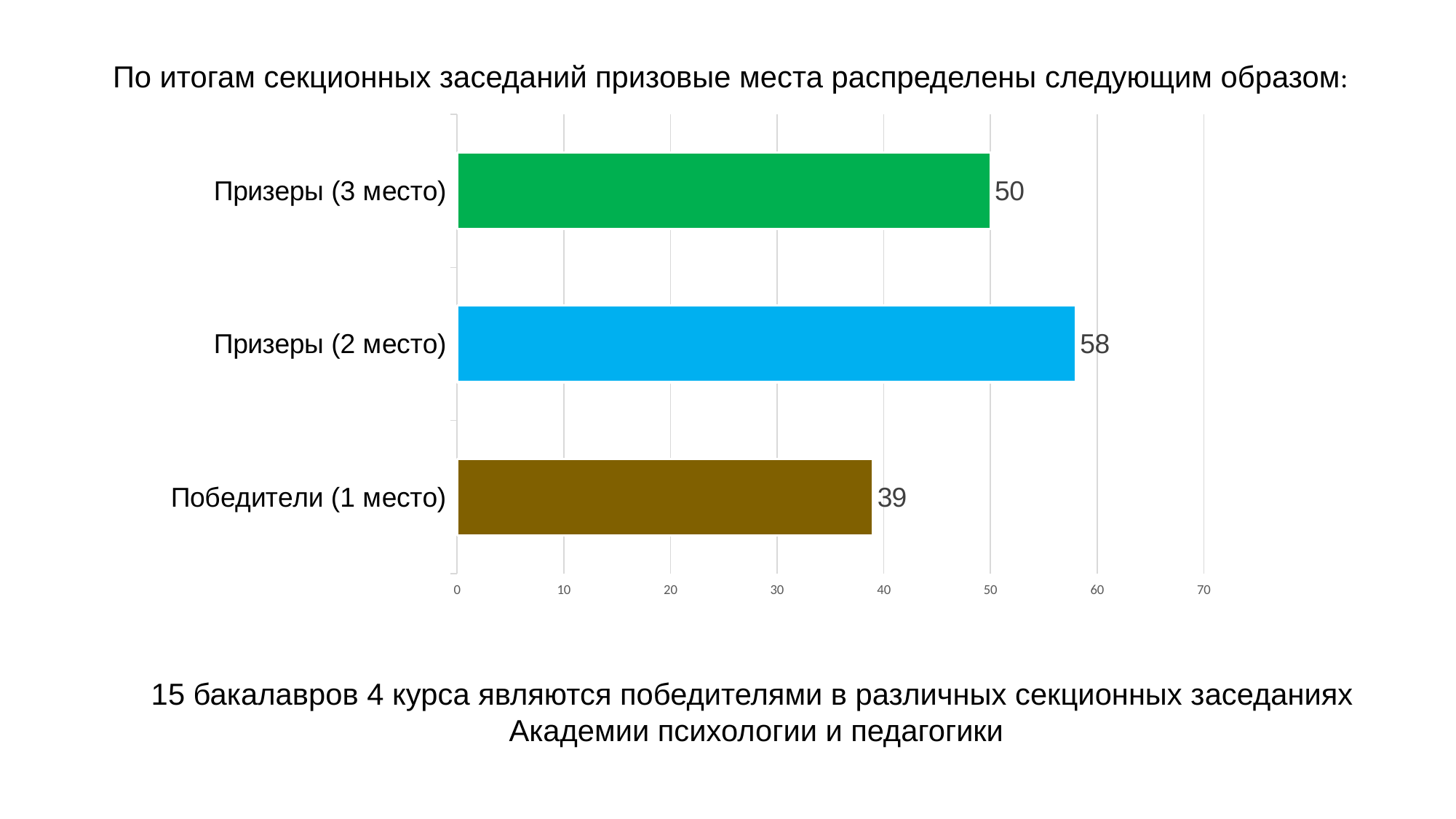
What is the value for Призеры (3 место)? 50 What is the difference between the values for Призеры (2 место) and Победители (1 место)? 19 What is the value for Победители (1 место)? 39 Which category has the lowest value? Победители (1 место) What kind of chart is shown on the slide? bar chart Which category has the highest value? Призеры (2 место) What colour is the bar for Призеры (2 место)? blue Which is larger, the value for Призеры (3 место) or Победители (1 место)? Призеры (3 место) Is the value for Победители (1 место) greater or less than 40? less What is the difference between the values for Призеры (2 место) and Призеры (3 место)? 8 How many categories are shown in the chart? 3 What is the value for Призеры (2 место)? 58